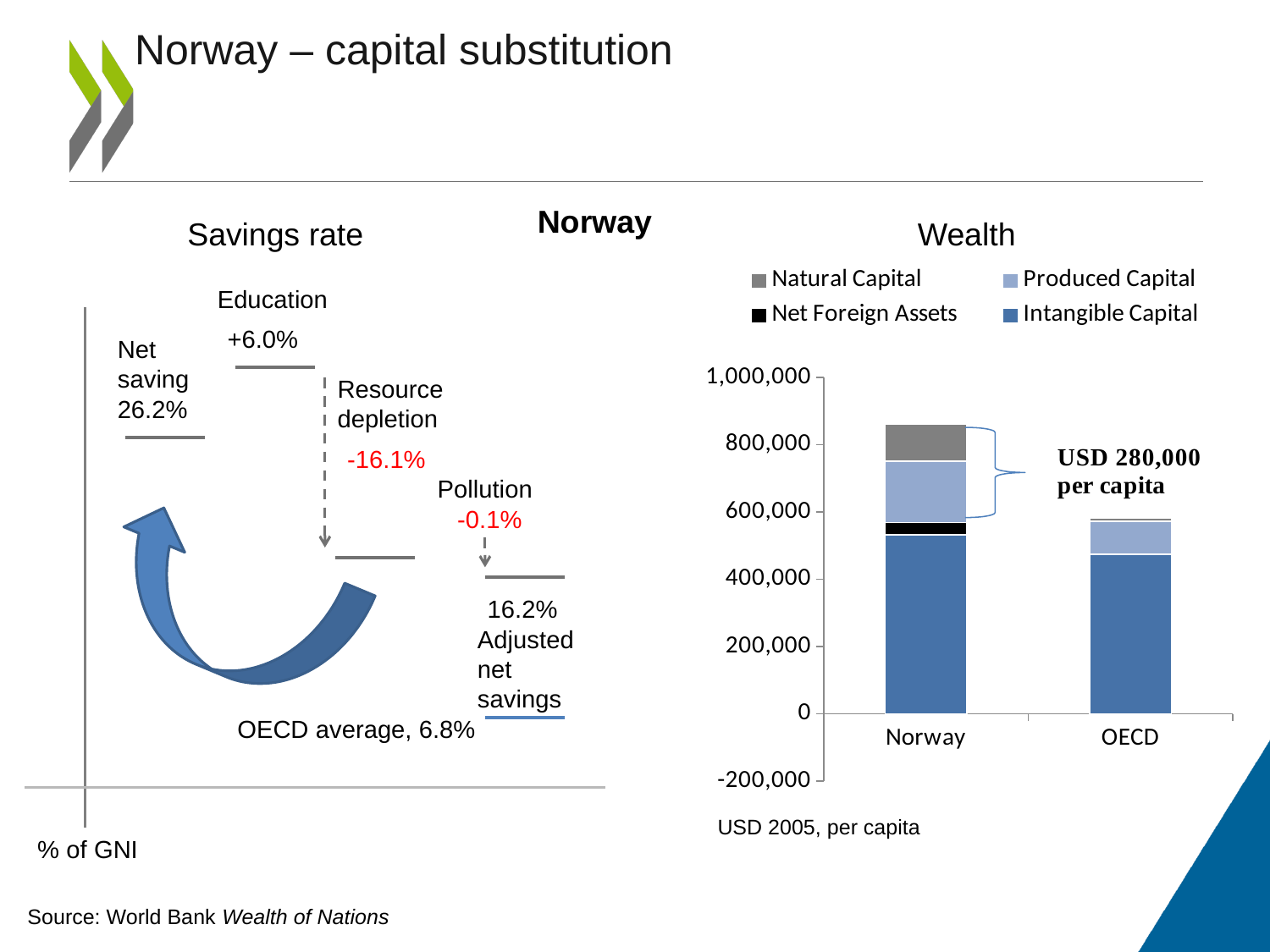
On the Savings rate chart, which is larger: Norway's adjusted net savings or the OECD average? Norway's adjusted net savings On the Savings rate chart, what is the value shown for Pollution? -0.1% On the Savings rate chart, what is the contribution of Education? +6.0% On the Savings rate chart, what is Norway's adjusted net savings? 16.2% What kind of chart is the Wealth chart? Stacked bar chart How many series does the legend of the Wealth chart list? 4 On the Savings rate chart, what is Norway's net saving as a % of GNI? 26.2% On the Wealth chart, which category has the taller stacked bar, Norway or OECD? Norway On the Savings rate chart, what is the value shown for Resource depletion? -16.1% On the Savings rate chart, by how many percentage points does Norway's adjusted net savings exceed the OECD average? 9.4 percentage points On the Savings rate chart, what is the OECD average adjusted net savings? 6.8% On the Wealth chart, is the total wealth per capita for Norway greater or less than 800,000? greater